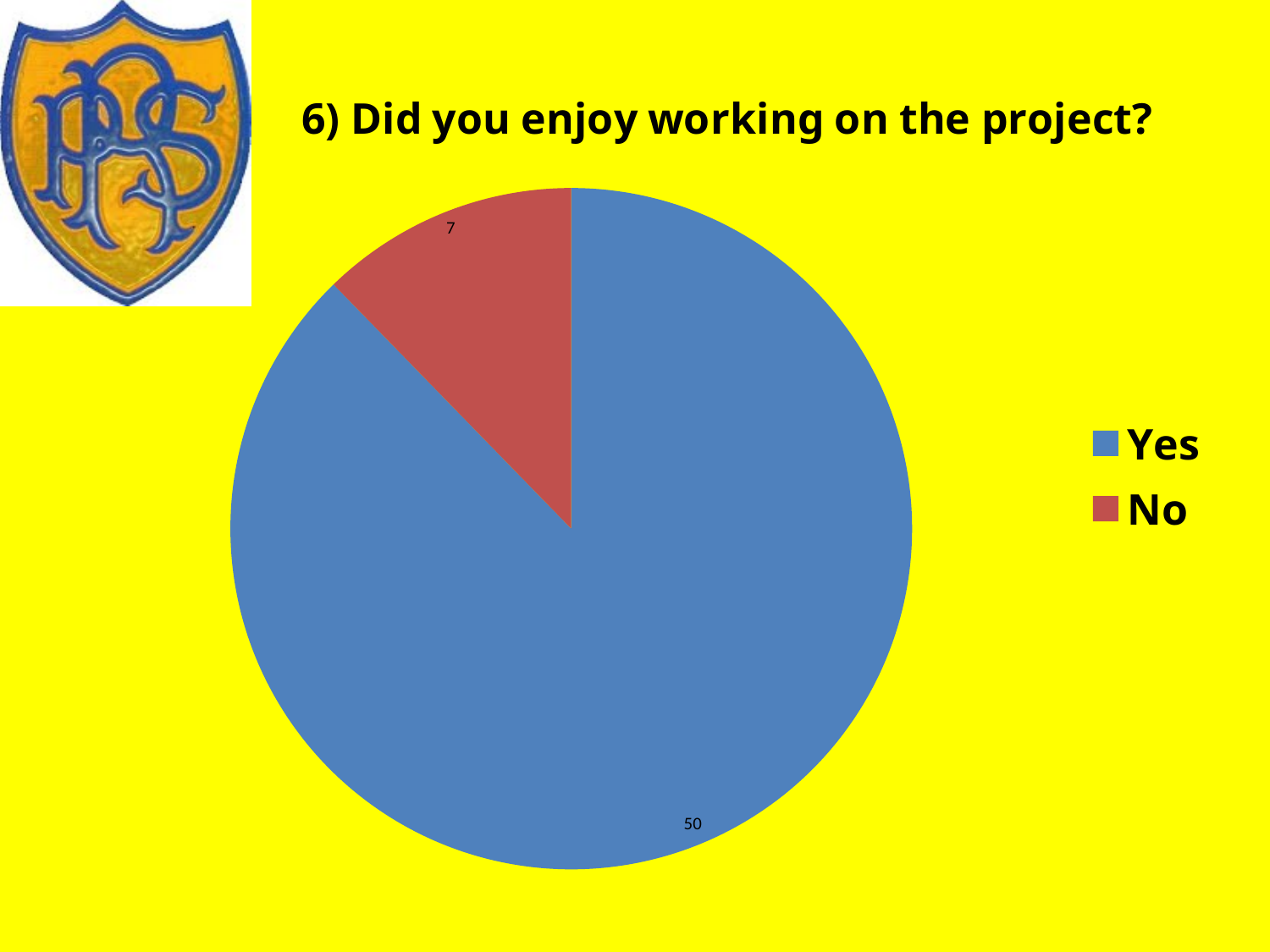
What is the total number of responses shown in the pie chart? 57 What is the difference between the number of Yes and No responses? 43 What colour is the Yes slice? blue What is the title of the chart? 6) Did you enjoy working on the project? Which is larger, the Yes slice or the No slice? Yes How many people answered Yes? 50 Which response has the smallest slice of the pie? No What type of chart is shown on the slide? pie chart How many categories does the pie chart have? 2 How many people answered No? 7 Which response has the largest slice of the pie? Yes